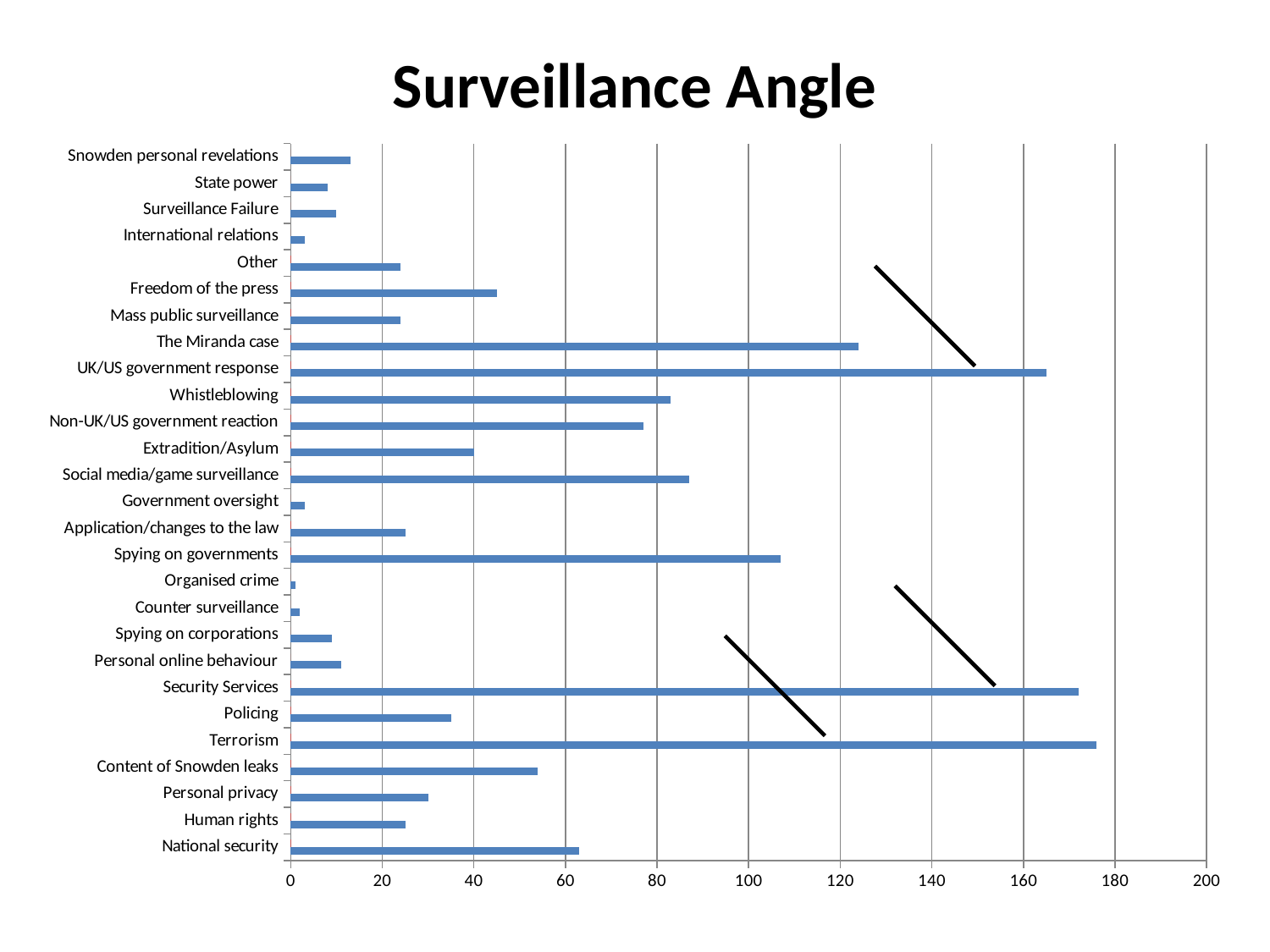
Is the value for Content of Snowden leaks greater or less than 60? less Is the value for Terrorism greater or less than 160? greater Is the value for Policing greater or less than 40? less How many categories are plotted on the chart? 27 Which is larger, the value for Terrorism or the value for Policing? Terrorism What kind of chart is shown on the slide? bar chart Which is larger, the value for The Miranda case or the value for Mass public surveillance? The Miranda case What is the title of the chart? Surveillance Angle Which is larger, the value for Spying on governments or the value for Spying on corporations? Spying on governments